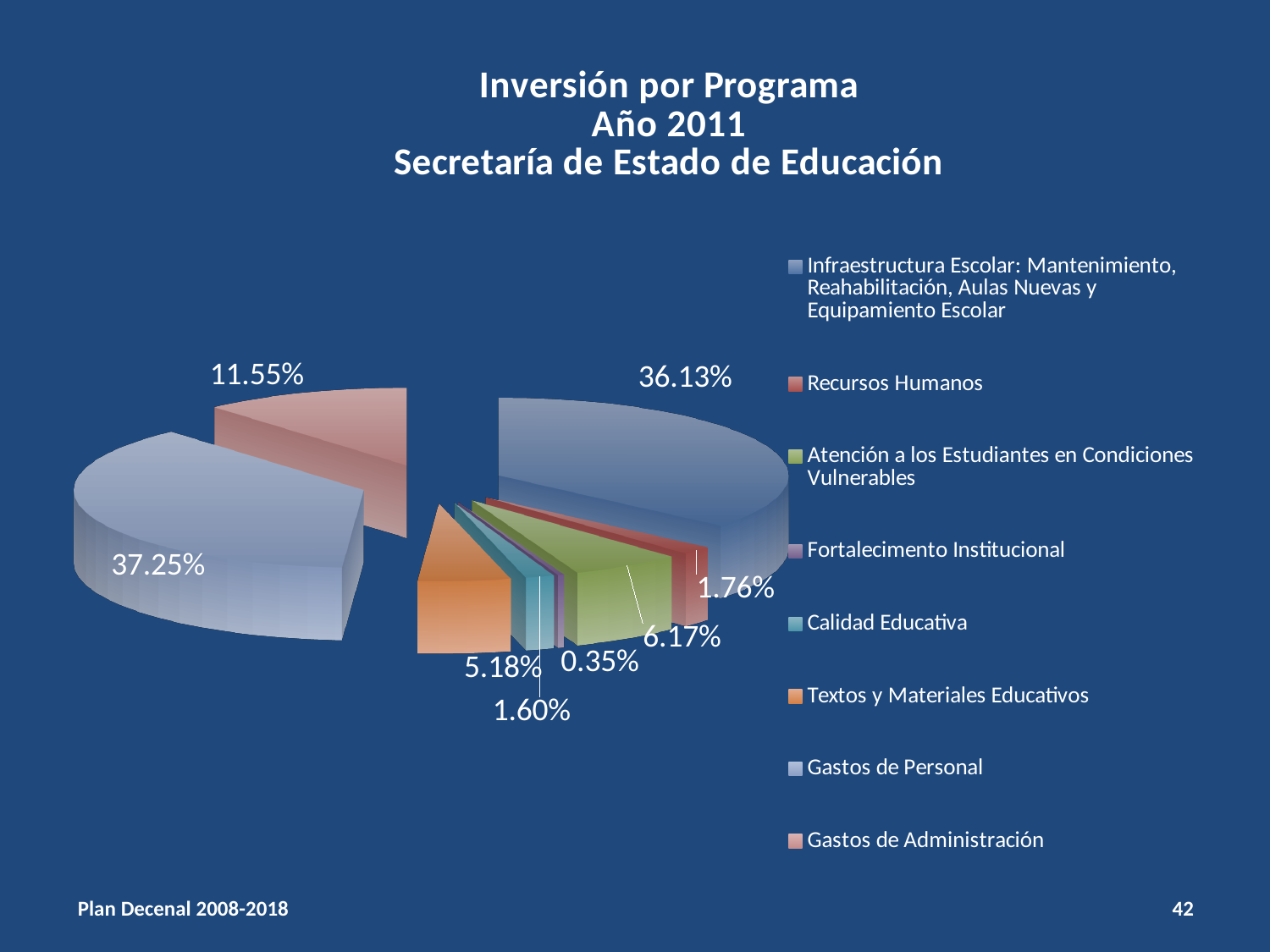
Which program has the largest share of the pie? Gastos de Personal What percentage is shown for Infraestructura Escolar: Mantenimiento, Reahabilitación, Aulas Nuevas y Equipamiento Escolar? 36.13% What year does the chart title say the investment by program refers to? 2011 What kind of chart is shown on the slide? Pie chart What percentage is shown for Recursos Humanos? 1.76% What percentage is shown for Atención a los Estudiantes en Condiciones Vulnerables? 6.17% Which program has the smallest share of the pie? Fortalecimento Institucional What is the difference in percentage points between Gastos de Personal and Infraestructura Escolar? 1.12 How many categories does the legend of the pie chart list? 8 Which is larger, the share for Gastos de Administración or the share for Atención a los Estudiantes en Condiciones Vulnerables? Gastos de Administración What percentage is shown for Gastos de Administración? 11.55% What share of the pie does Gastos de Personal represent? 37.25%